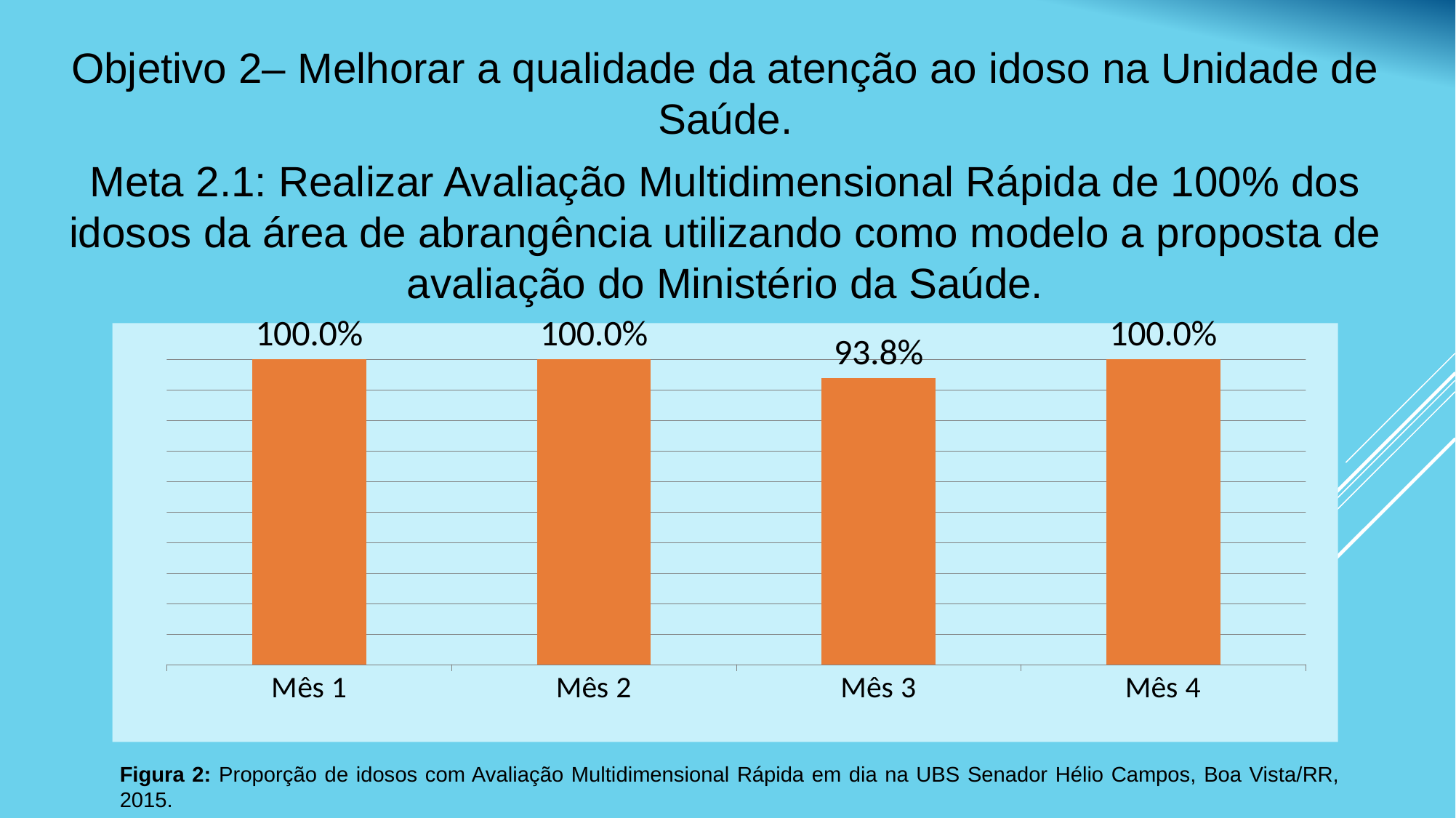
Which is larger, the value for Mês 3 or the value for Mês 4? Mês 4 What kind of chart is shown on the slide? Bar chart Does the value fall or rise from Mês 2 to Mês 3? Fall How many months reach 100.0%? 3 What is the value for Mês 1? 100.0% How many months are shown on the x axis? 4 What is the difference between the values for Mês 2 and Mês 3? 6.2% What colour are the bars in the chart? Orange Which month has the lowest value? Mês 3 What is the value for Mês 4? 100.0% According to the figure caption, in which city is the UBS Senador Hélio Campos located? Boa Vista/RR What is the value for Mês 3? 93.8%